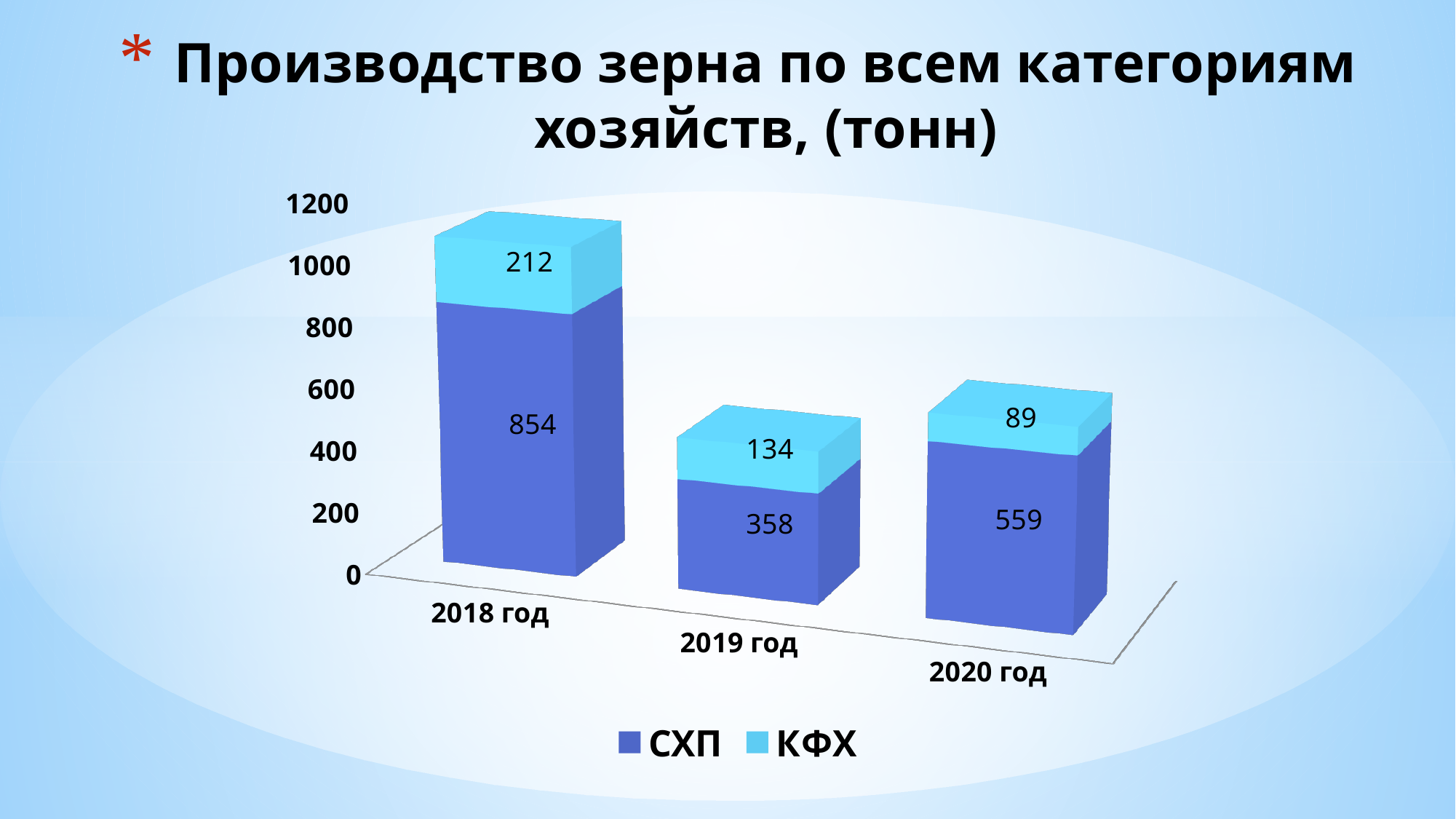
What is the value for КФХ in 2019 год? 134 What is the value for КФХ in 2020 год? 89 Which year has the highest value for СХП? 2018 год What kind of chart is shown on the slide? Stacked bar chart What is the difference between the СХП values for 2020 год and 2019 год? 201 How many series does the legend list? 2 What is the total of the stacked bar for 2019 год? 492 How many years are shown on the x axis? 3 What is the total of the stacked bar for 2018 год? 1066 Which year has the lowest value for КФХ? 2020 год Which is larger: КФХ in 2018 год or КФХ in 2019 год? КФХ in 2018 год What is the value for СХП in 2018 год? 854